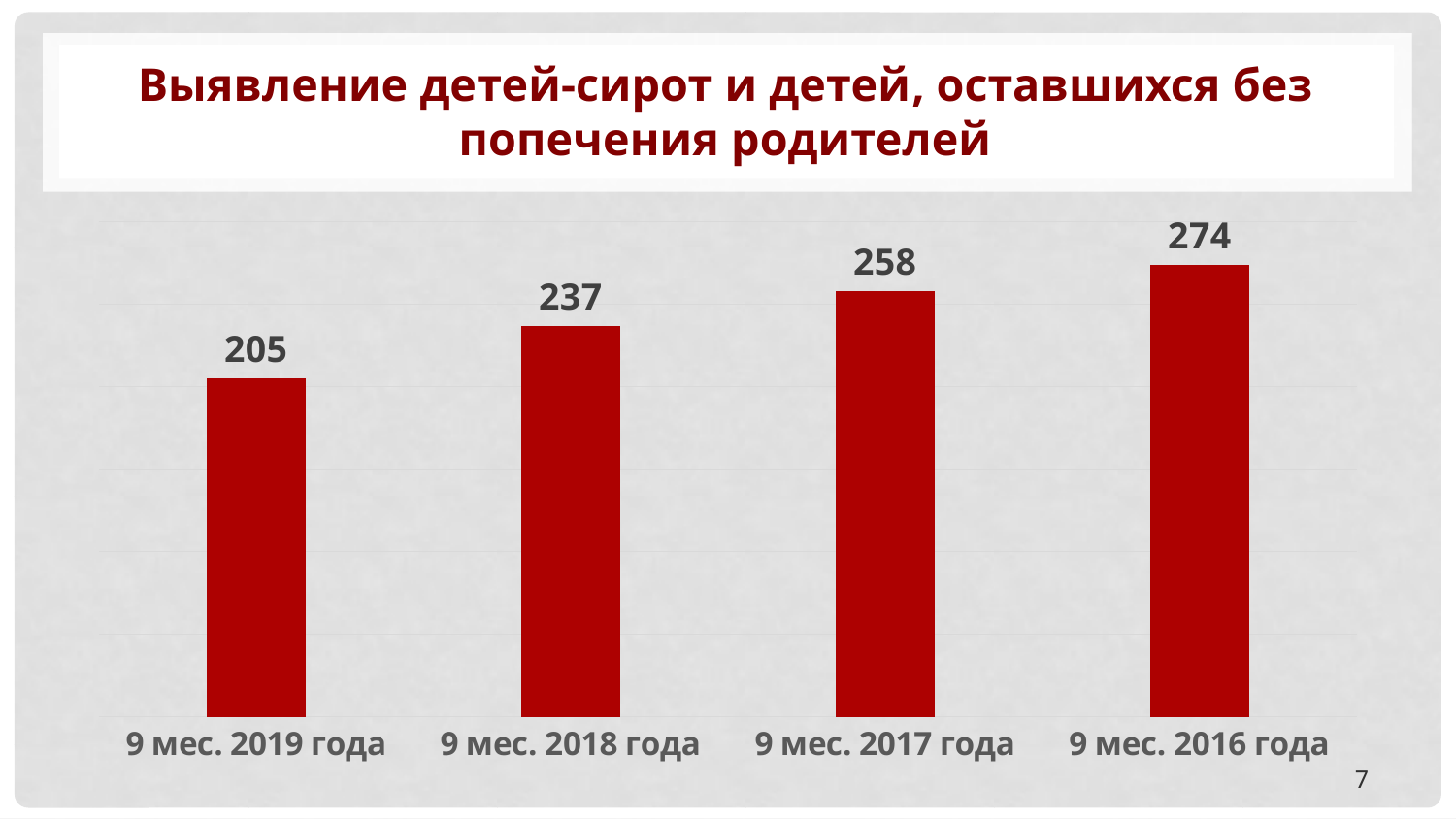
What is the difference between the values for 9 мес. 2018 года and 9 мес. 2019 года? 32 Which is larger, the value for 9 мес. 2018 года or 9 мес. 2017 года? 9 мес. 2017 года What is the title of the chart? Выявление детей-сирот и детей, оставшихся без попечения родителей What kind of chart is shown on the slide? bar chart How many categories are shown on the chart? 4 Which category has the highest value? 9 мес. 2016 года What is the value for 9 мес. 2016 года? 274 What is the value for 9 мес. 2017 года? 258 Do the values rise or fall from left to right along the x axis? rise What is the value for 9 мес. 2019 года? 205 What is the difference between the values for 9 мес. 2016 года and 9 мес. 2019 года? 69 Which category has the lowest value? 9 мес. 2019 года